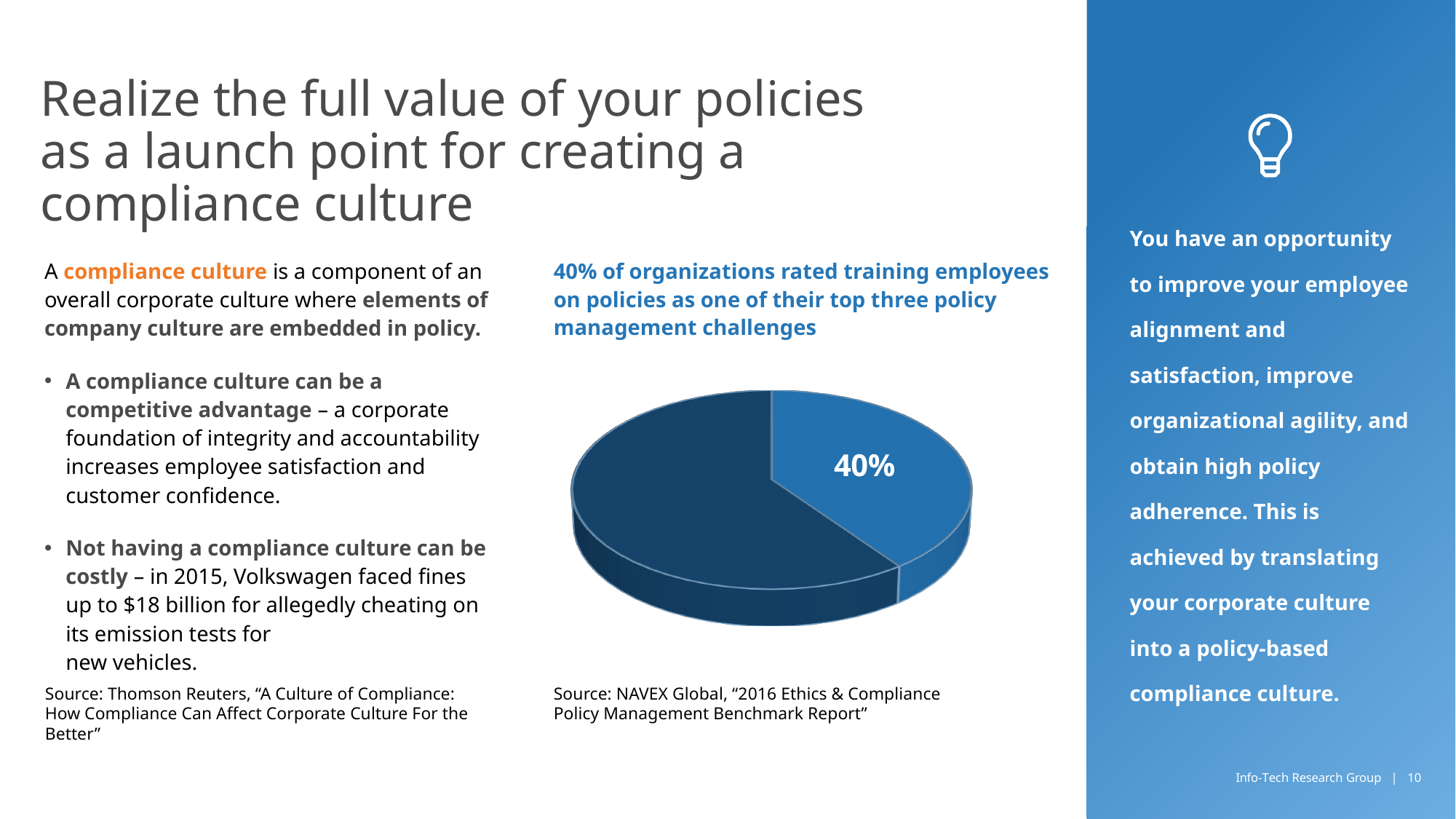
How many slices does the pie chart have? 2 Which slice of the pie chart is larger, the slice labeled 40% or the unlabeled slice? the unlabeled slice What share of the pie does the unlabeled slice represent? 60% Which slice of the pie chart is shown in the lighter blue colour? the 40% slice According to the text above the pie chart, what does the 40% slice represent? organizations that rated training employees on policies as one of their top three policy management challenges How many data labels are printed on the pie chart? 1 Is the slice labeled 40% more or less than half of the pie? less What percentage is printed on the labeled slice of the pie chart? 40% What kind of chart is shown on the slide? pie chart